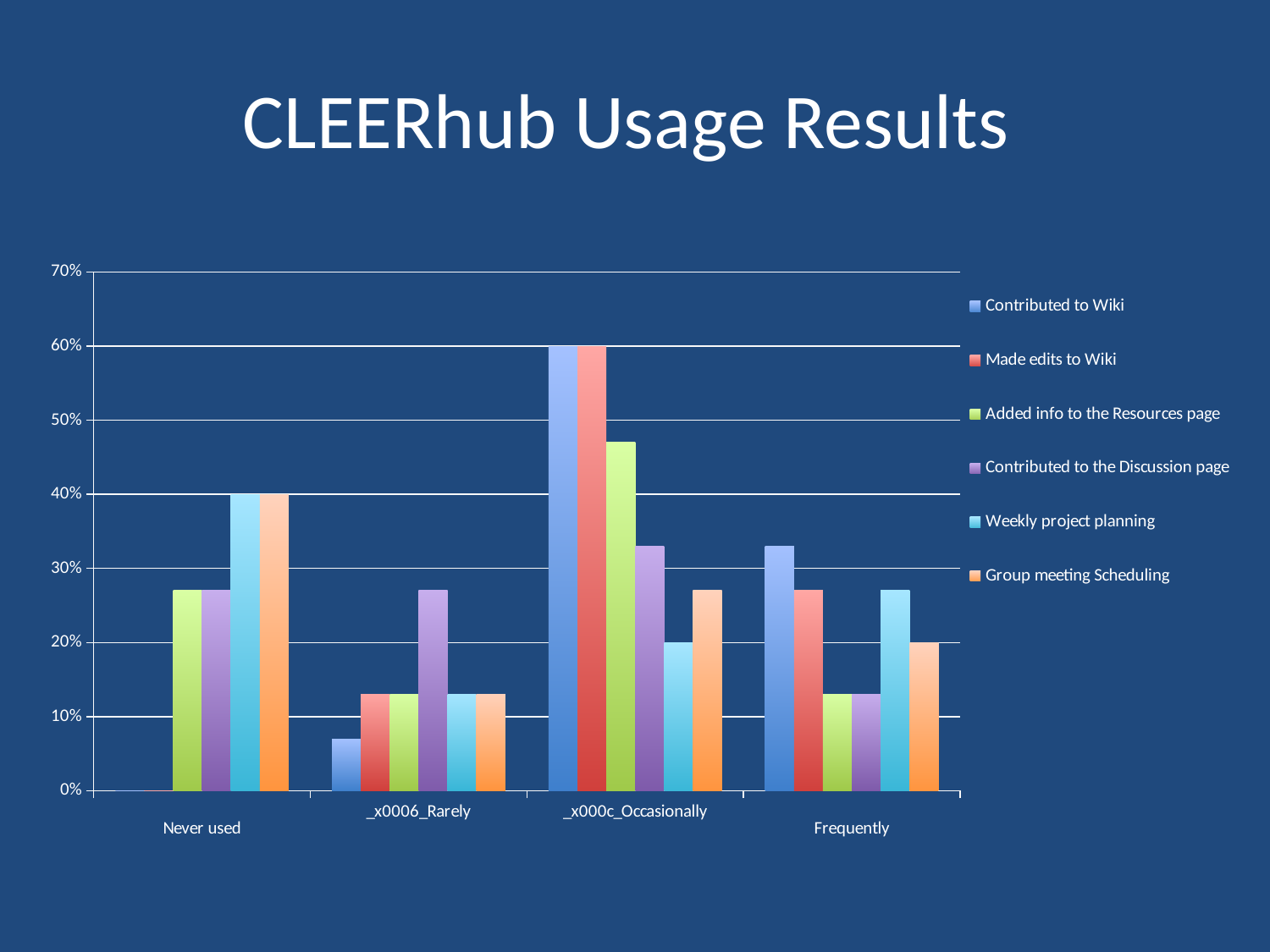
What is the value for Group meeting Scheduling in the Frequently category? 20% Is the value for Contributed to Wiki in the _x0006_Rarely category greater or less than 10%? less How many categories are shown on the x axis? 4 What is the value for Contributed to Wiki in the _x000c_Occasionally category? 60% What is the value for Weekly project planning in the Never used category? 40% What is the value for Weekly project planning in the _x000c_Occasionally category? 20% Which category has the lowest value for Group meeting Scheduling? _x0006_Rarely In the Frequently category, which is larger: Contributed to Wiki or Added info to the Resources page? Contributed to Wiki How many series does the legend list? 6 Which category has the highest value for Contributed to Wiki? _x000c_Occasionally What kind of chart is shown on the slide? bar chart Is the value for Added info to the Resources page in the _x000c_Occasionally category greater or less than 40%? greater